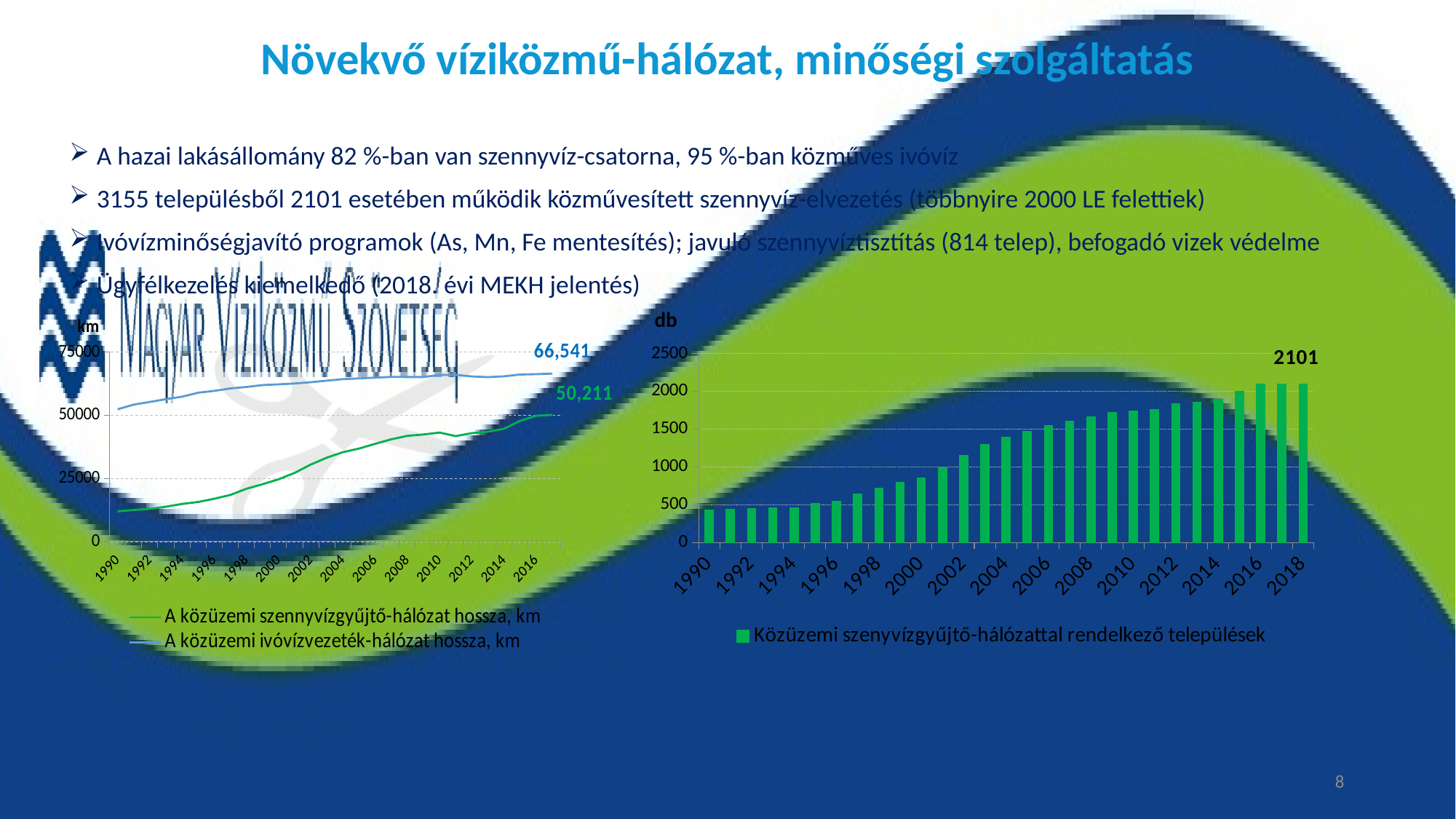
On the left line chart, what is the last data label shown for the drinking water network (A közüzemi ivóvízvezeték-hálózat hossza, km)? 66,541 On the right bar chart, is the value for 2000 greater or less than 1000? less On the left line chart, what is the difference between the two final data labels, 66,541 and 50,211? 16,330 On the left line chart, which series has the higher value at the end of the period: the drinking water network or the sewer network? A közüzemi ivóvízvezeték-hálózat hossza, km On the left line chart, how many series does the legend list? 2 On the right bar chart, which year has the highest value? 2018 On the left line chart, is the sewer network length in 1990 greater or less than 25000? less On the right bar chart, what is the value labelled for 2018? 2101 On the left line chart, do the values of the sewer network series rise or fall from 1990 to 2016? rise On the left line chart, what is the last data label shown for the sewer network (A közüzemi szennyvízgyűjtő-hálózat hossza, km)? 50,211 On the right bar chart, is the value for 2010 greater or less than 1500? greater What kind of chart is the right-hand chart (db)? bar chart